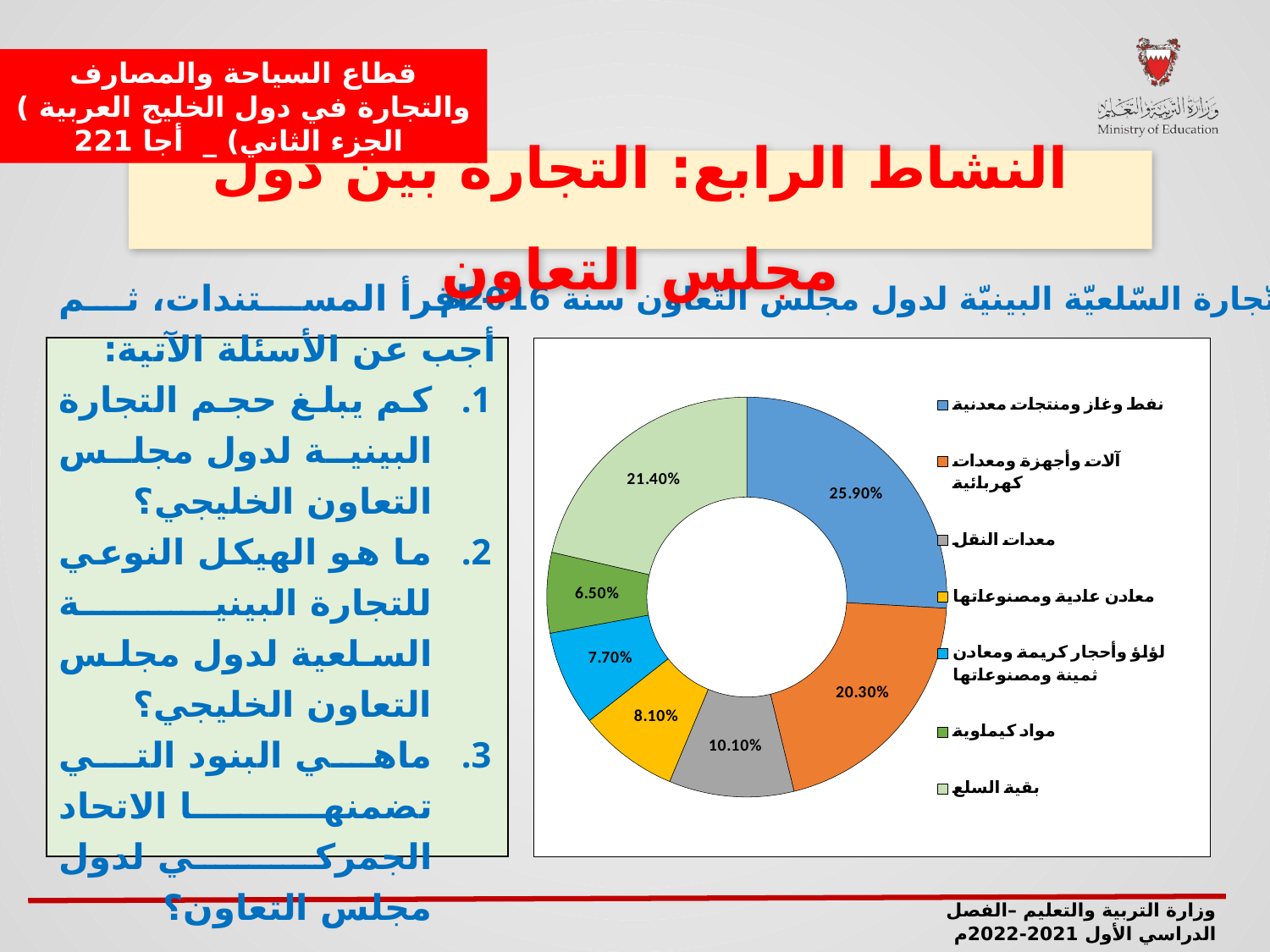
Which is larger: the share of معادن عادية ومصنوعاتها or the share of لؤلؤ وأحجار كريمة ومعادن ثمينة ومصنوعاتها? معادن عادية ومصنوعاتها What is the value for آلات وأجهزة ومعدات كهربائية? 20.30% What is the value for معدات النقل? 10.10% What colour is the slice for معدات النقل? Grey What is the difference between the shares of نفط وغاز ومنتجات معدنية and آلات وأجهزة ومعدات كهربائية? 5.60% Which category has the smallest share of the chart? مواد كيماوية What is the value for نفط وغاز ومنتجات معدنية? 25.90% What is the value for مواد كيماوية? 6.50% How many categories does the chart show? 7 What is the value for بقية السلع? 21.40% What kind of chart is shown on the slide? Doughnut (pie) chart Which category has the largest share of the chart? نفط وغاز ومنتجات معدنية